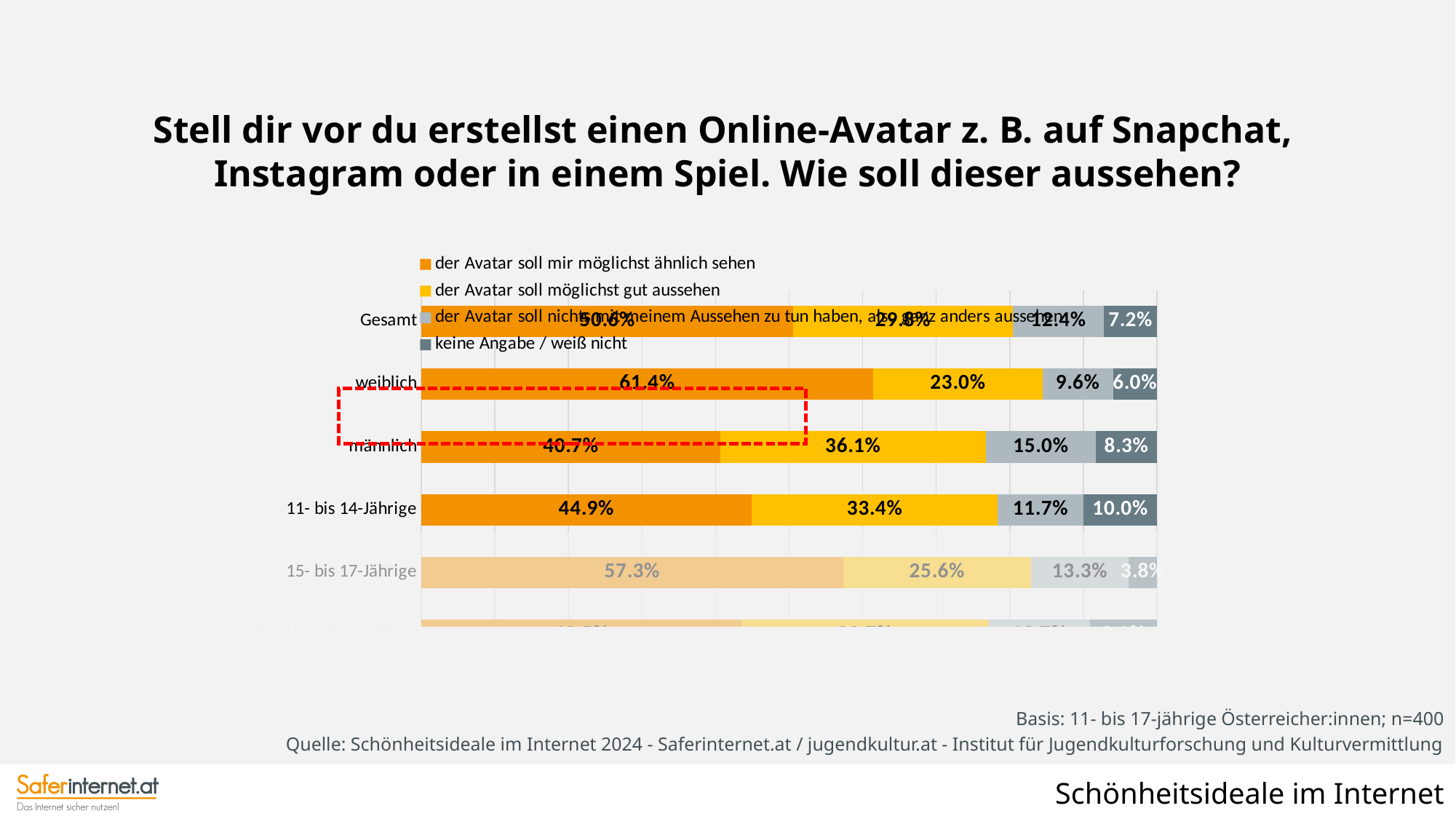
How many series does the legend list? 4 What is the difference between the weiblich and männlich values for 'der Avatar soll mir möglichst ähnlich sehen'? 20.7 percentage points Which category has the lowest value for 'der Avatar soll mir möglichst ähnlich sehen' among Gesamt, weiblich, männlich, 11- bis 14-Jährige and 15- bis 17-Jährige? männlich What is the value for 'der Avatar soll mir möglichst ähnlich sehen' in the weiblich category? 61.4% What is the value for 'der Avatar soll mir möglichst ähnlich sehen' in the 15- bis 17-Jährige category? 57.3% Which category has the highest value for 'der Avatar soll mir möglichst ähnlich sehen' among Gesamt, weiblich, männlich, 11- bis 14-Jährige and 15- bis 17-Jährige? weiblich What is the value for 'der Avatar soll mir möglichst ähnlich sehen' in the Gesamt category? 50.6% Which is larger: the 'der Avatar soll möglichst gut aussehen' value for 11- bis 14-Jährige or for 15- bis 17-Jährige? 11- bis 14-Jährige What is the value for 'der Avatar soll möglichst gut aussehen' in the männlich category? 36.1% What kind of chart is shown on the slide? stacked bar chart What is the first legend entry of the chart? der Avatar soll mir möglichst ähnlich sehen What is the value for 'keine Angabe / weiß nicht' in the 11- bis 14-Jährige category? 10.0%